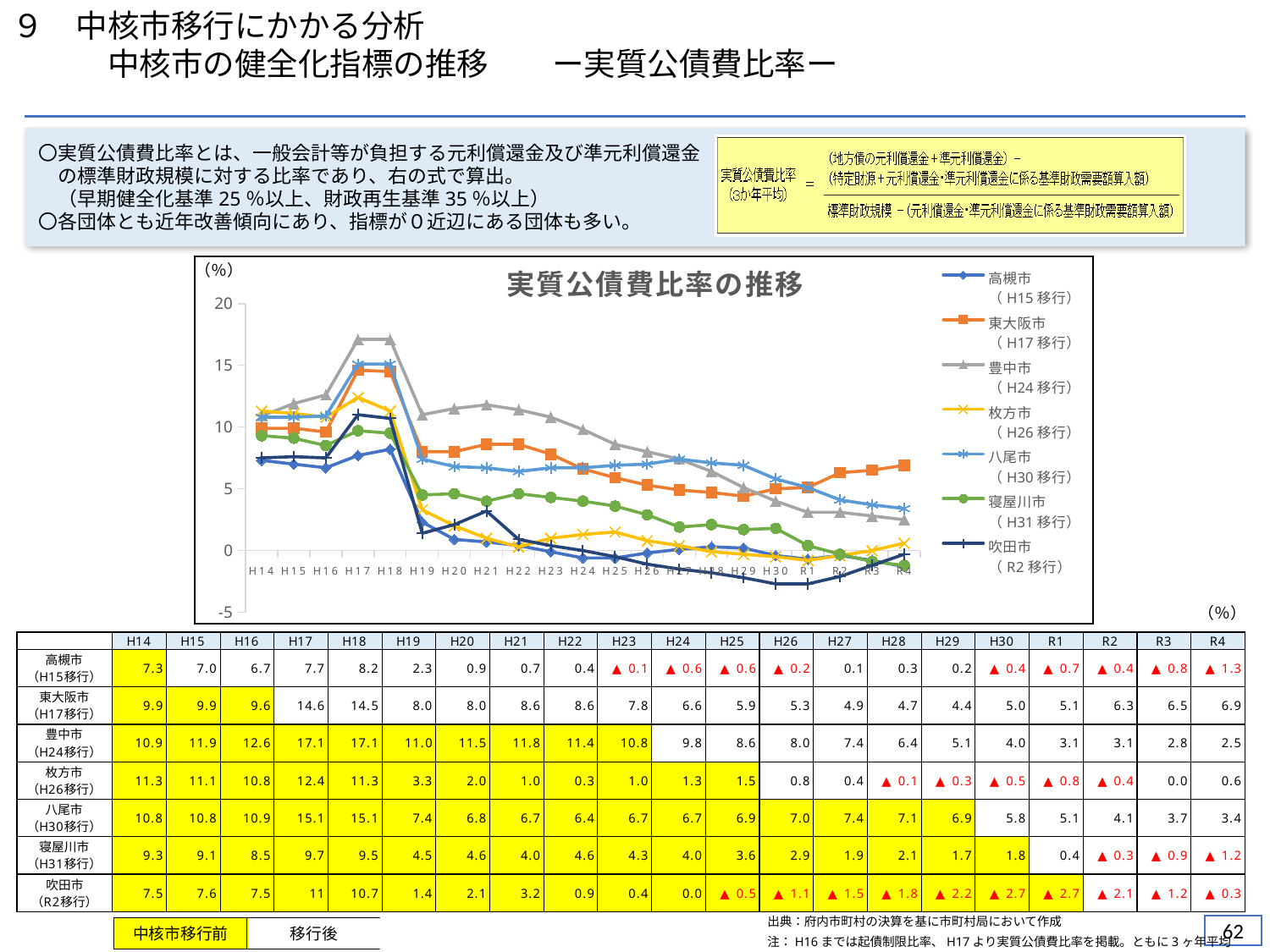
How many series does the legend of the chart list? 7 What is the 実質公債費比率 of 八尾市 in H14? 10.8 Does the 実質公債費比率 of 豊中市 generally rise or fall from H18 to R4? fall What kind of chart is 実質公債費比率の推移? line chart How many fiscal years are plotted along the x axis of the chart (H14 to R4)? 21 What is the 実質公債費比率 of 豊中市 in H18? 17.1 Which city has the lowest 実質公債費比率 in H30? 吹田市 In R4, which is larger, the 実質公債費比率 of 東大阪市 or 八尾市? 東大阪市 What is the 実質公債費比率 of 東大阪市 in R4? 6.9 Which city has the highest 実質公債費比率 in H17? 豊中市 What is the difference between the 実質公債費比率 of 豊中市 and 東大阪市 in H17? 2.5 Is the 実質公債費比率 of 豊中市 in H17 greater or less than 15? greater